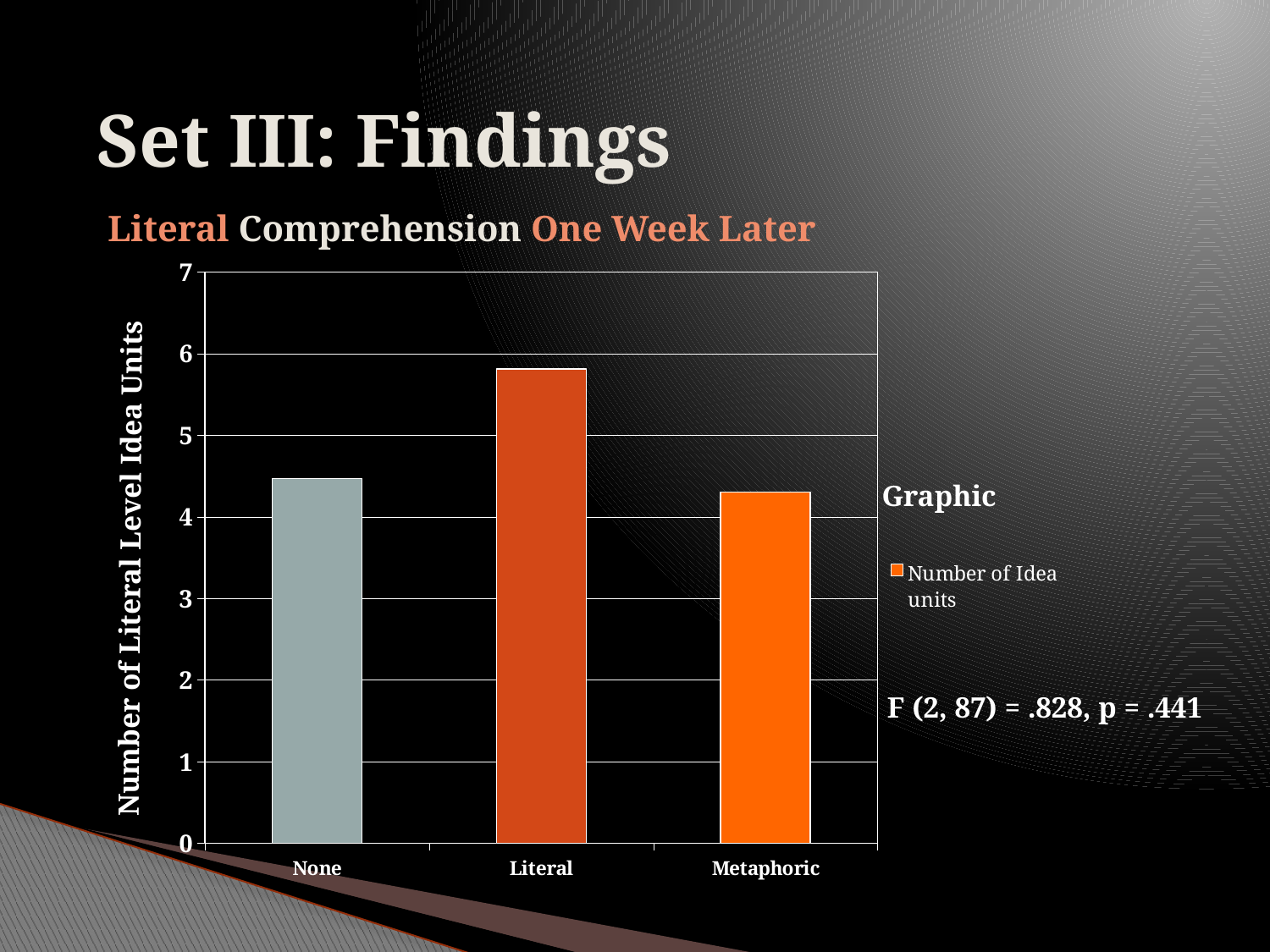
What is the label of the series listed in the chart's legend? Number of Idea units What is the title of the chart's y axis? Number of Literal Level Idea Units Is the value for None greater or less than 4? greater Is the value for Literal greater or less than 6? less How many series does the chart's legend list? 1 What kind of chart is shown on the slide? bar chart Which is larger, the value for Literal or the value for Metaphoric? Literal Is the value for Metaphoric greater or less than 5? less Which category has the highest number of literal level idea units? Literal How many categories are shown on the x axis of the chart? 3